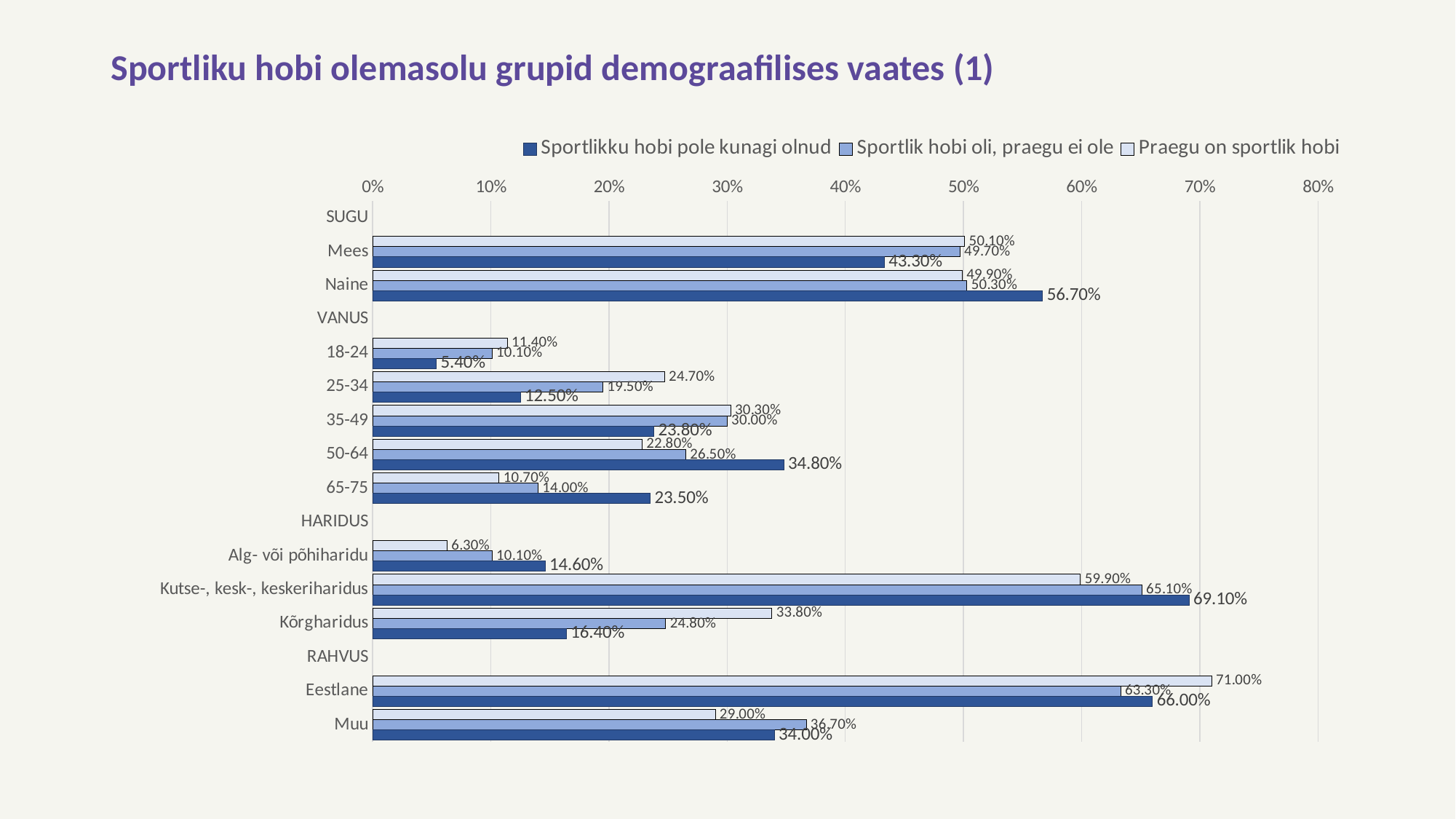
Is the value for Kutse-, kesk-, keskeriharidus in the series "Sportlikku hobi pole kunagi olnud" greater or less than 60%? greater Which age group has the highest value in the series "Sportlikku hobi pole kunagi olnud"? 50-64 What is the value for Naine in the series "Sportlikku hobi pole kunagi olnud"? 56.70% What kind of chart is shown on the slide? bar chart What is the difference between Eestlane and Muu in the series "Praegu on sportlik hobi"? 42.00% Which category has the lowest value in the series "Praegu on sportlik hobi"? Alg- või põhiharidu What is the title of the chart? Sportliku hobi olemasolu grupid demograafilises vaates (1) What is the difference between Naine and Mees in the series "Sportlikku hobi pole kunagi olnud"? 13.40% How many series does the legend list? 3 What is the value for Kõrgharidus in the series "Praegu on sportlik hobi"? 33.80% Which is larger for Kõrgharidus: "Sportlikku hobi pole kunagi olnud" or "Praegu on sportlik hobi"? Praegu on sportlik hobi What is the value for 25-34 in the series "Sportlik hobi oli, praegu ei ole"? 19.50%